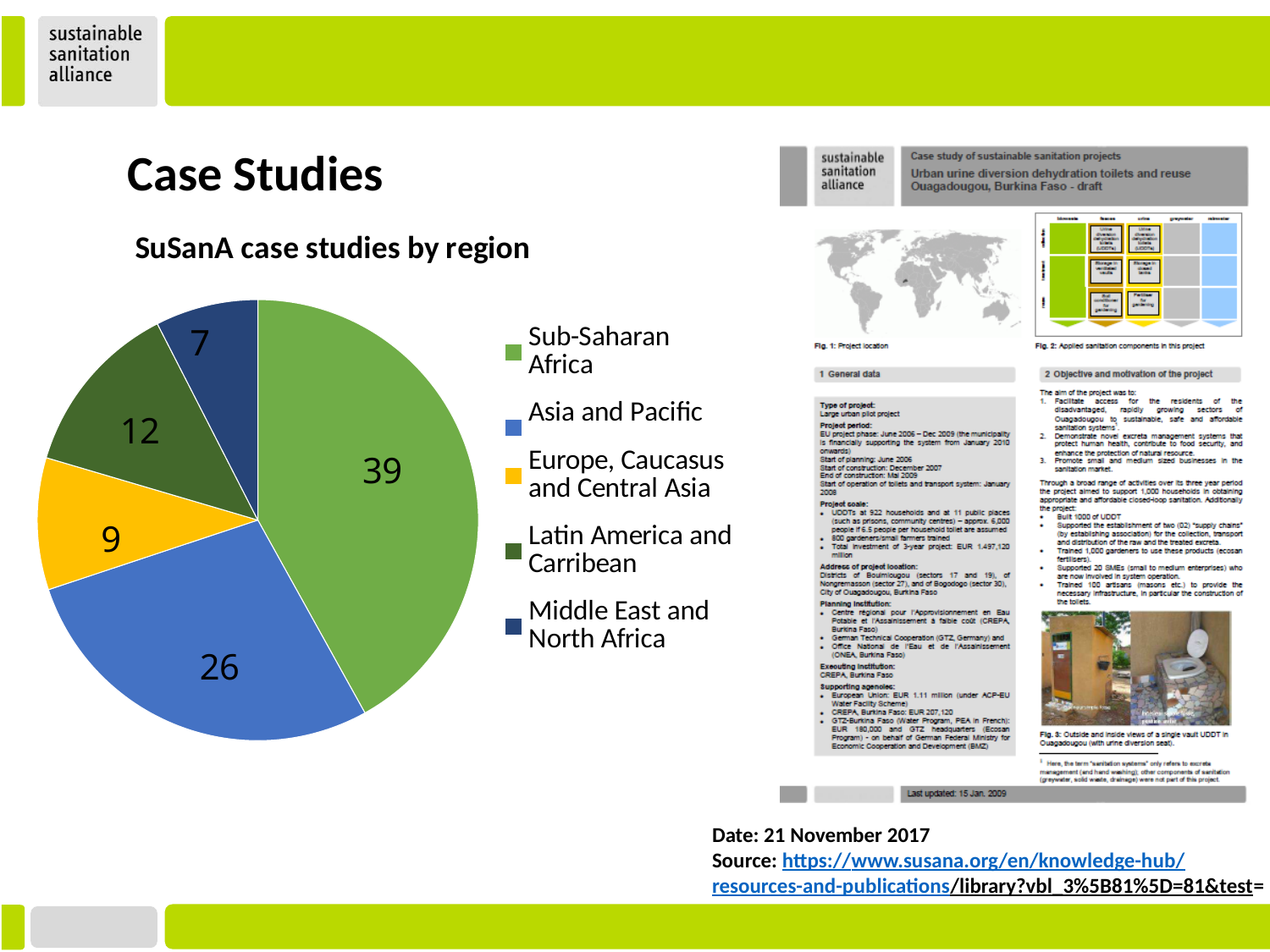
Which region has the smallest number of case studies? Middle East and North Africa What is the title of the chart? SuSanA case studies by region How many case studies are from Sub-Saharan Africa? 39 Which has more case studies: Europe, Caucasus and Central Asia or Latin America and Carribean? Latin America and Carribean How many case studies are from Asia and Pacific? 26 What kind of chart is shown on the slide? Pie chart How many regions are shown in the pie chart? 5 What is the difference between the number of case studies in Sub-Saharan Africa and in Asia and Pacific? 13 How many case studies are from Latin America and Carribean? 12 Which region has the largest number of case studies? Sub-Saharan Africa What is the total number of case studies across all regions in the pie chart? 93 How many case studies are from Middle East and North Africa? 7